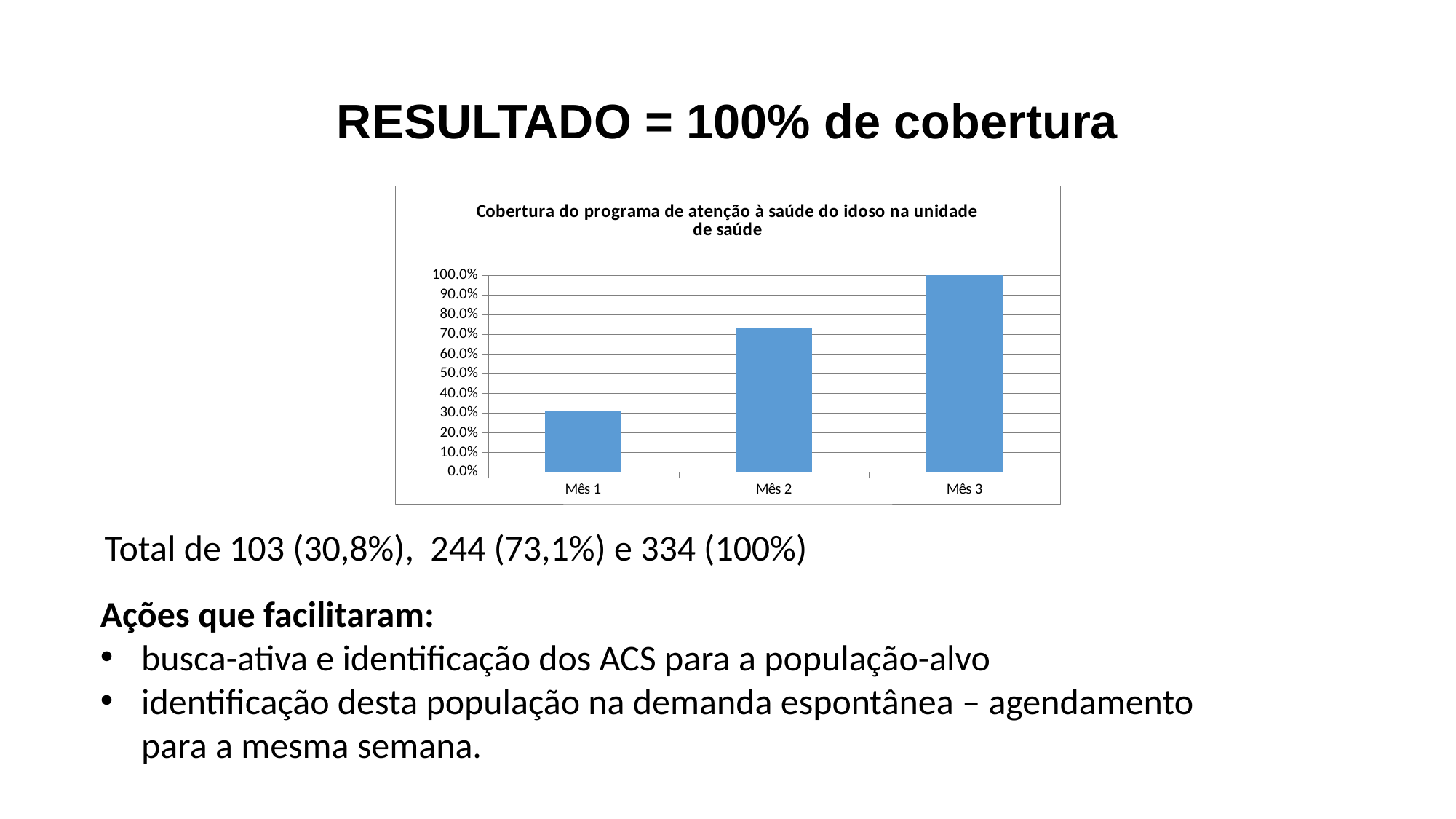
Which is larger, the value for Mês 1 or the value for Mês 2? Mês 2 Which month has the lowest coverage in the chart? Mês 1 Do the values rise or fall from Mês 1 to Mês 3? rise Is the value for Mês 2 greater or less than 80.0%? less Is the value for Mês 1 greater or less than 20.0%? greater What kind of chart is shown on the slide? bar chart What is the title of the chart? Cobertura do programa de atenção à saúde do idoso na unidade de saúde Is the value for Mês 1 greater or less than 40.0%? less How many categories are plotted on the x axis of the chart? 3 What is the coverage value for Mês 3 in the chart? 100.0% Which month has the highest coverage in the chart? Mês 3